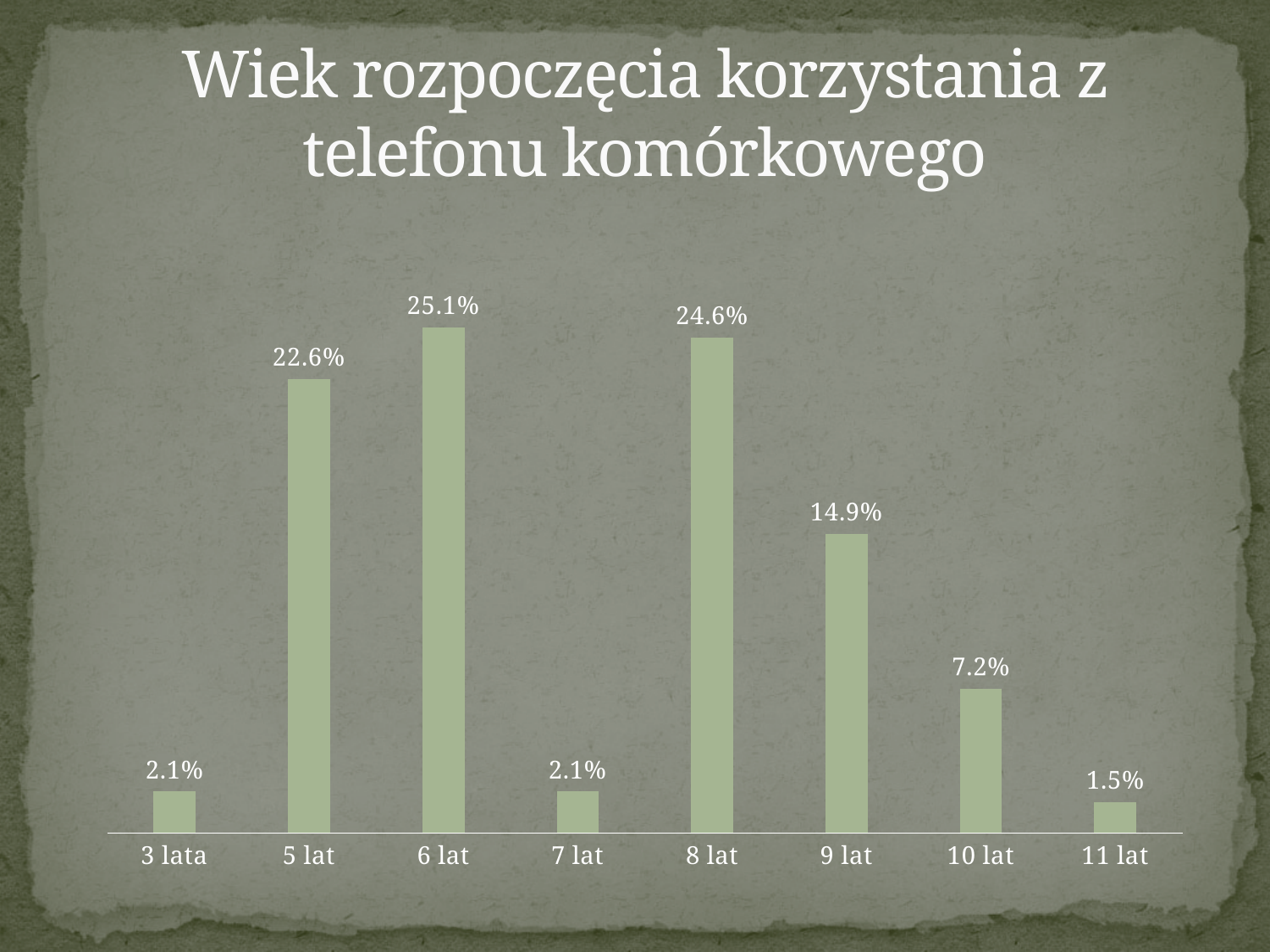
What is the difference between the values for 5 lat and 9 lat? 7.7% What kind of chart is shown on the slide? bar chart Which category has the highest value? 6 lat What is the value for 10 lat? 7.2% What is the value for 9 lat? 14.9% Which category has the lowest value? 11 lat Which is larger, the value for 10 lat or the value for 11 lat? 10 lat Which is larger, the value for 5 lat or the value for 9 lat? 5 lat What is the value for 6 lat? 25.1% What is the title of the chart? Wiek rozpoczęcia korzystania z telefonu komórkowego What is the difference between the values for 6 lat and 8 lat? 0.5% How many categories are shown on the x axis? 8